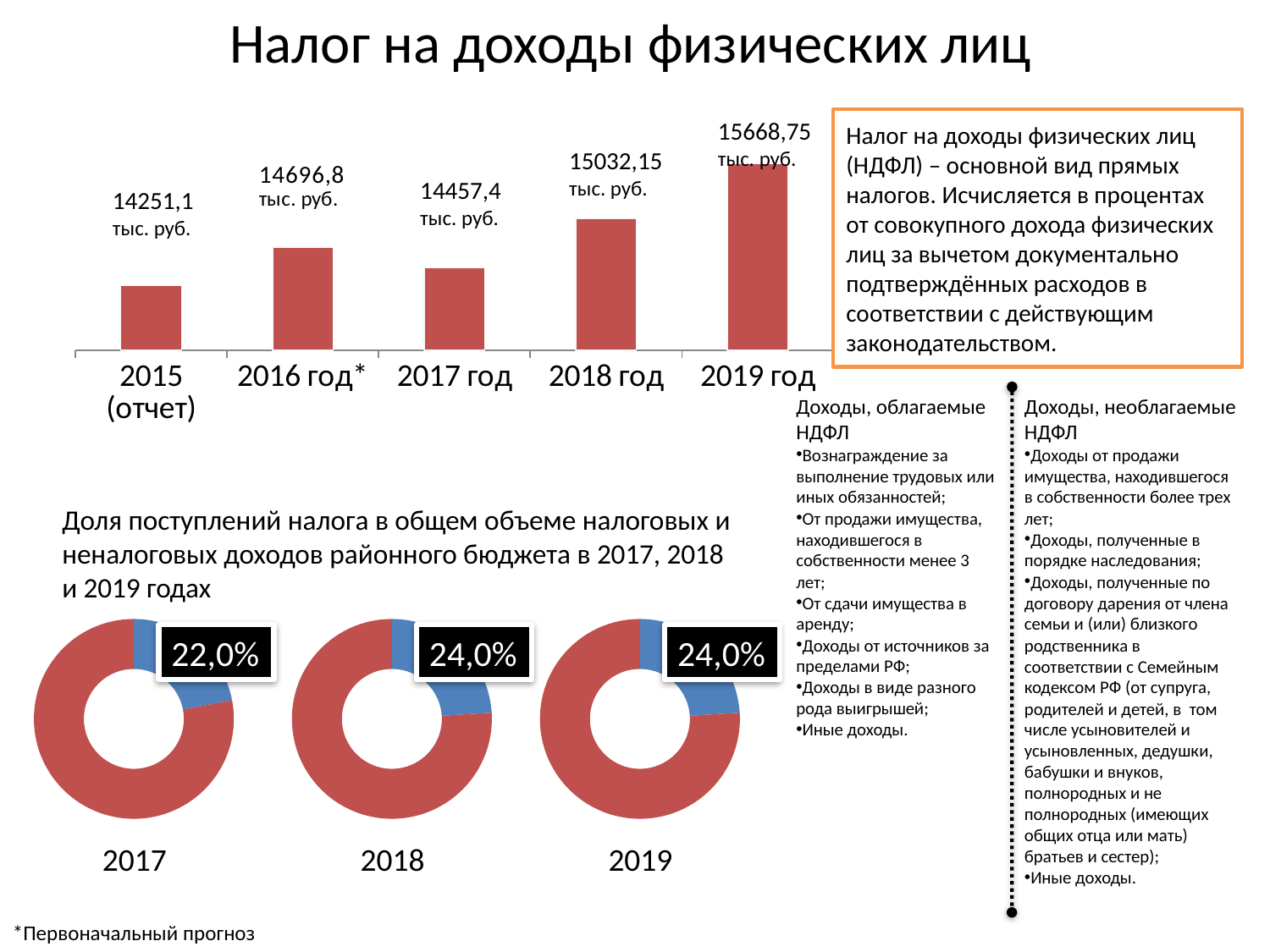
In the bar chart at the top of the slide, does the value rise or fall from 2018 год to 2019 год? Rise In the bar chart at the top of the slide, which is larger: the value for 2016 год* or the value for 2017 год? 2016 год* In the bar chart at the top of the slide, which year has the lowest value? 2015 (отчет) In the bar chart at the top of the slide, what is the value for 2015 (отчет)? 14251,1 тыс. руб. In the bar chart at the top of the slide, what is the difference between the values for 2019 год and 2018 год? 636,6 тыс. руб. What type of chart is shown at the top of the slide? Bar chart In the bar chart at the top of the slide, what is the value for 2016 год*? 14696,8 тыс. руб. In the bar chart at the top of the slide, which year has the highest value? 2019 год In the bar chart at the top of the slide, what is the value for 2018 год? 15032,15 тыс. руб. In the donut chart for 2017 at the bottom of the slide, what share is labelled? 22,0% In the donut charts at the bottom of the slide, what share is labelled for 2019? 24,0% How many bars are in the bar chart at the top of the slide? 5